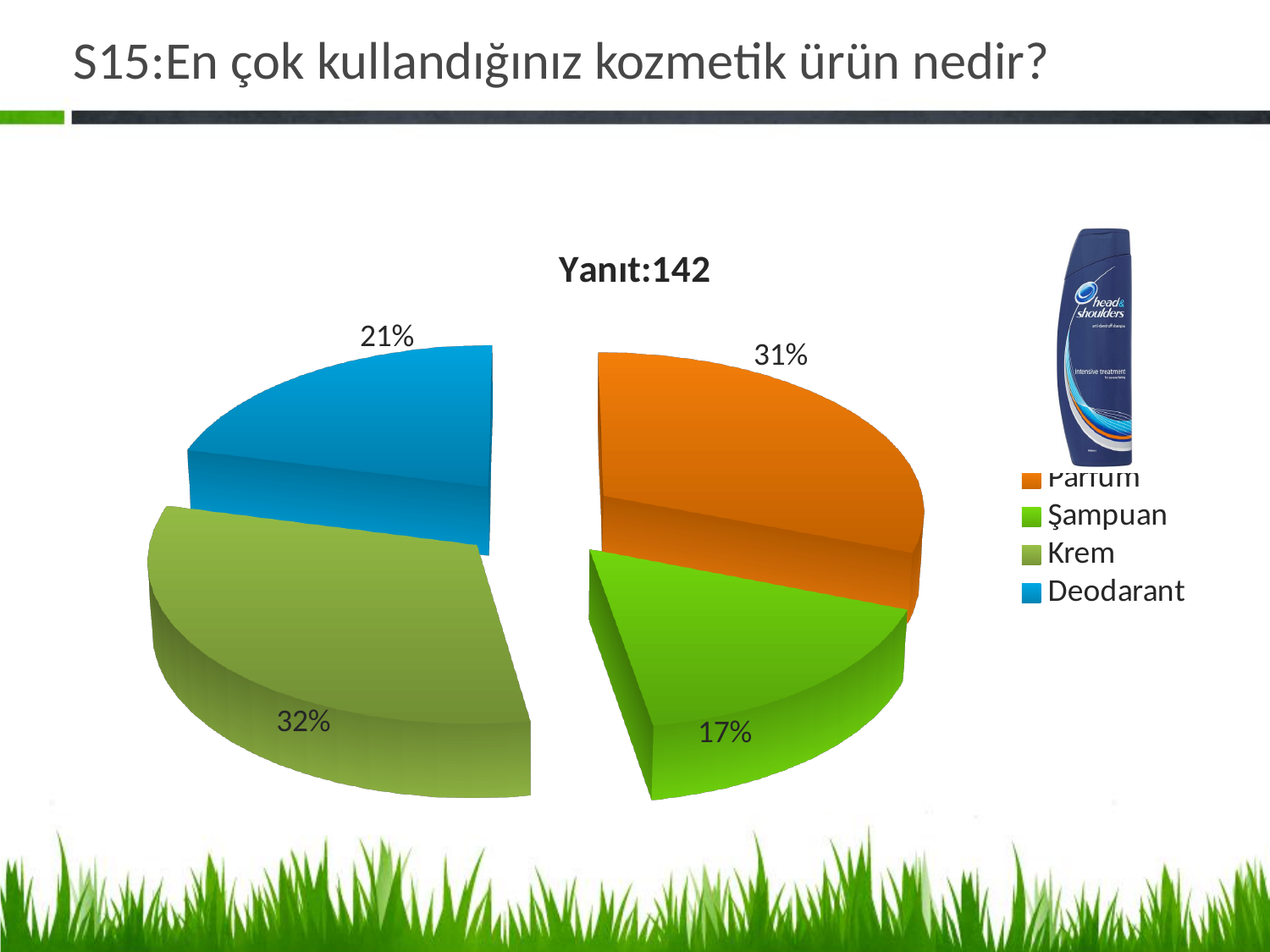
What percentage of the pie does Parfüm account for? 31% How many categories are shown in the pie chart? 4 What colour is the Deodarant slice in the pie chart? blue What percentage of the pie does Şampuan account for? 17% What percentage of the pie does Deodarant account for? 21% Which category has the largest share of the pie? Krem What is the difference in percentage points between Krem and Şampuan? 15 Which category has the smallest share of the pie? Şampuan What percentage of the pie does Krem account for? 32% What type of chart is shown on the slide? pie chart Which is larger, the share for Deodarant or the share for Şampuan? Deodarant What is the title of the chart? Yanıt:142